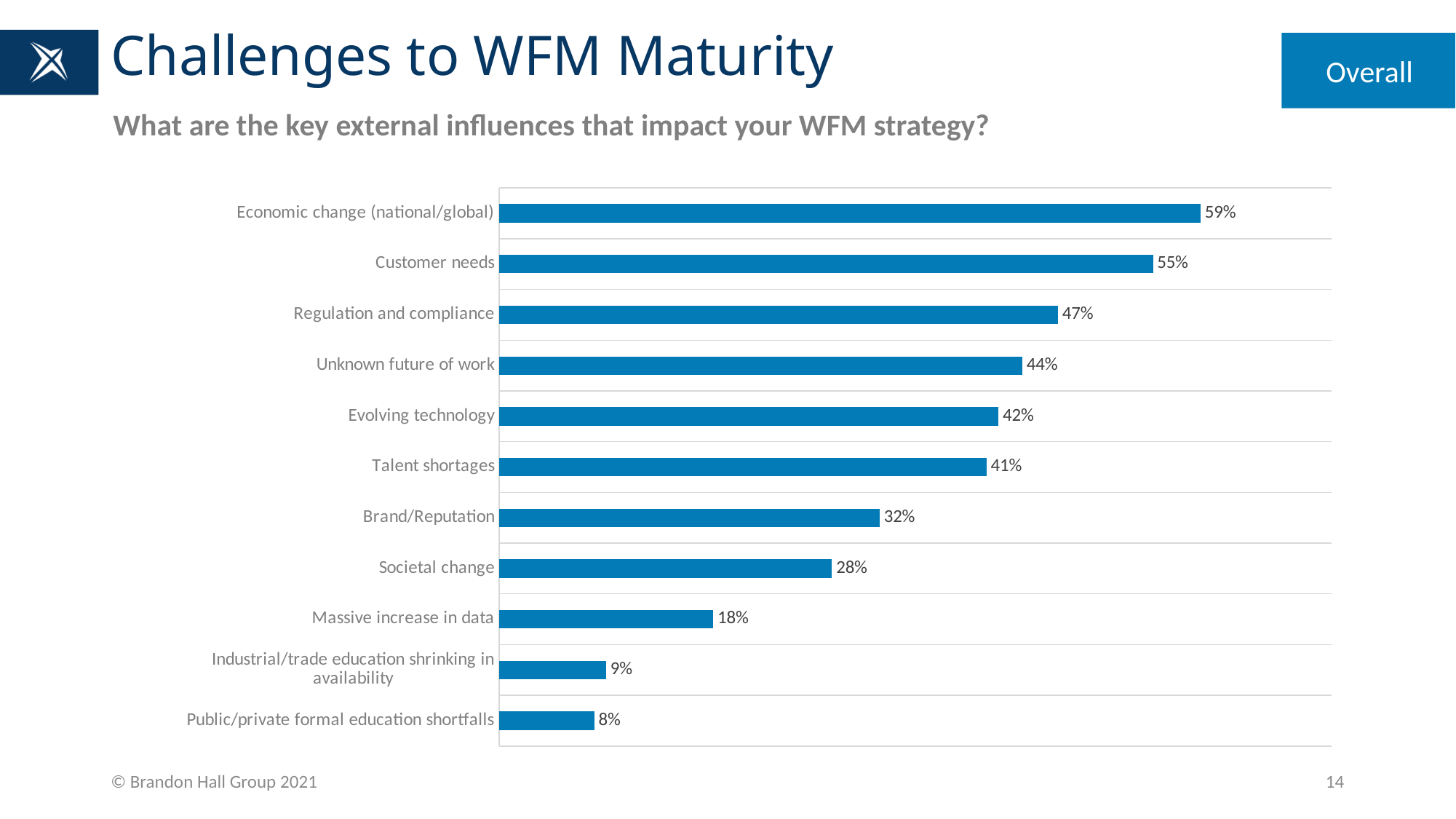
Which external influence has the highest percentage? Economic change (national/global) What is the value shown for Talent shortages? 41% What percentage of respondents cited Economic change (national/global) as a key external influence? 59% Which external influence has the lowest percentage? Public/private formal education shortfalls How many external influences are listed in the chart? 11 What is the difference in percentage points between Brand/Reputation and Societal change? 4 What is the value shown for Massive increase in data? 18% Which has a higher value, Unknown future of work or Evolving technology? Unknown future of work Which has a higher value, Industrial/trade education shrinking in availability or Public/private formal education shortfalls? Industrial/trade education shrinking in availability What is the difference in percentage points between Customer needs and Regulation and compliance? 8 What question does the chart answer, according to the subtitle? What are the key external influences that impact your WFM strategy? What kind of chart is shown on the slide? Bar chart